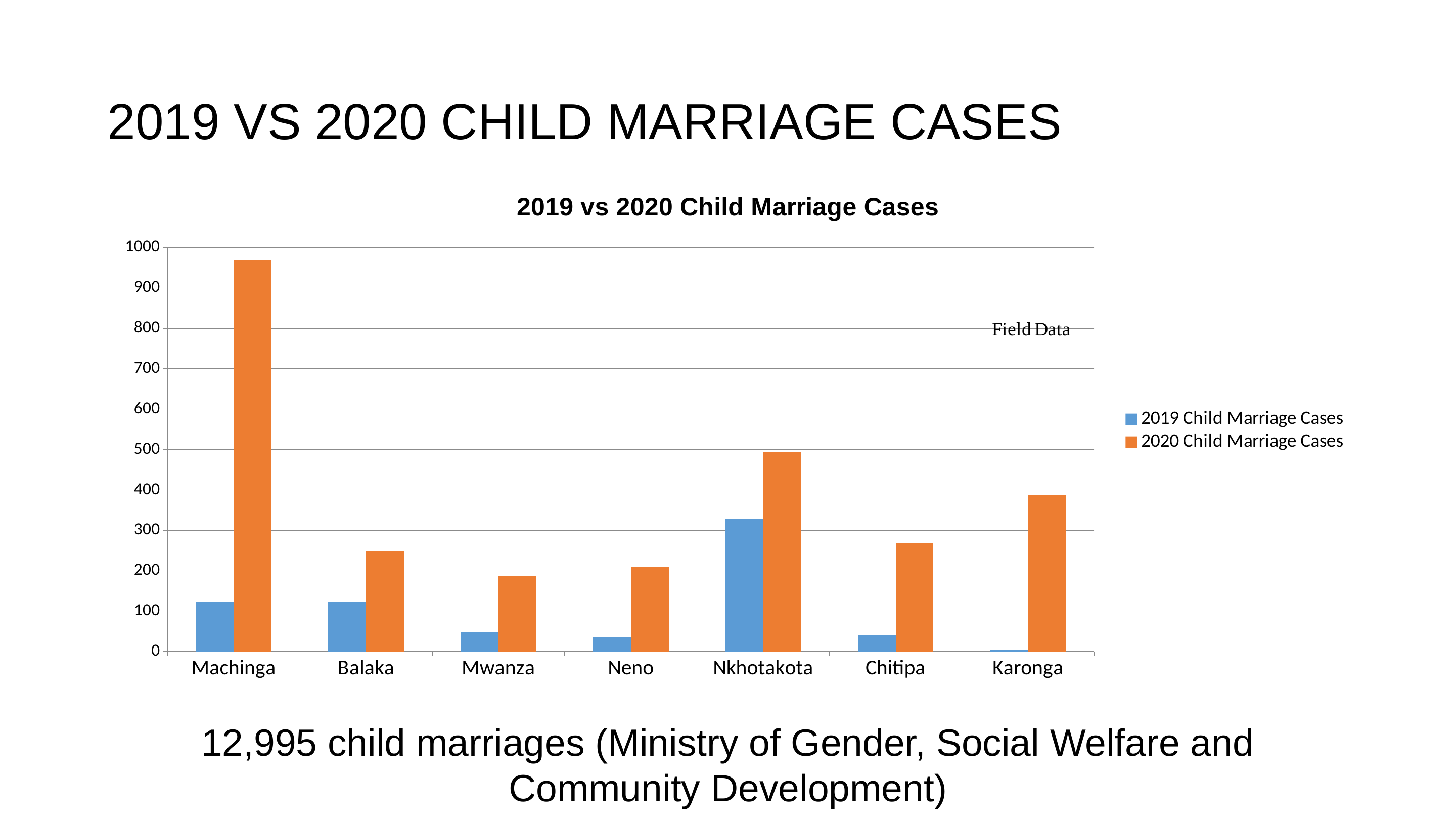
What kind of chart is shown on the slide? bar chart Is the value for Chitipa's 2019 Child Marriage Cases greater or less than 100? less Is the value for Nkhotakota's 2019 Child Marriage Cases greater or less than 300? greater Is the value for Machinga's 2020 Child Marriage Cases greater or less than 900? greater How many series does the chart's legend list? 2 Which district has the highest 2019 Child Marriage Cases? Nkhotakota What colour are the bars for the 2020 Child Marriage Cases series? orange Which is larger: the 2020 Child Marriage Cases for Nkhotakota or for Karonga? Nkhotakota Which district has the highest 2020 Child Marriage Cases? Machinga Which district has the lowest 2019 Child Marriage Cases? Karonga How many districts are shown on the x axis of the chart? 7